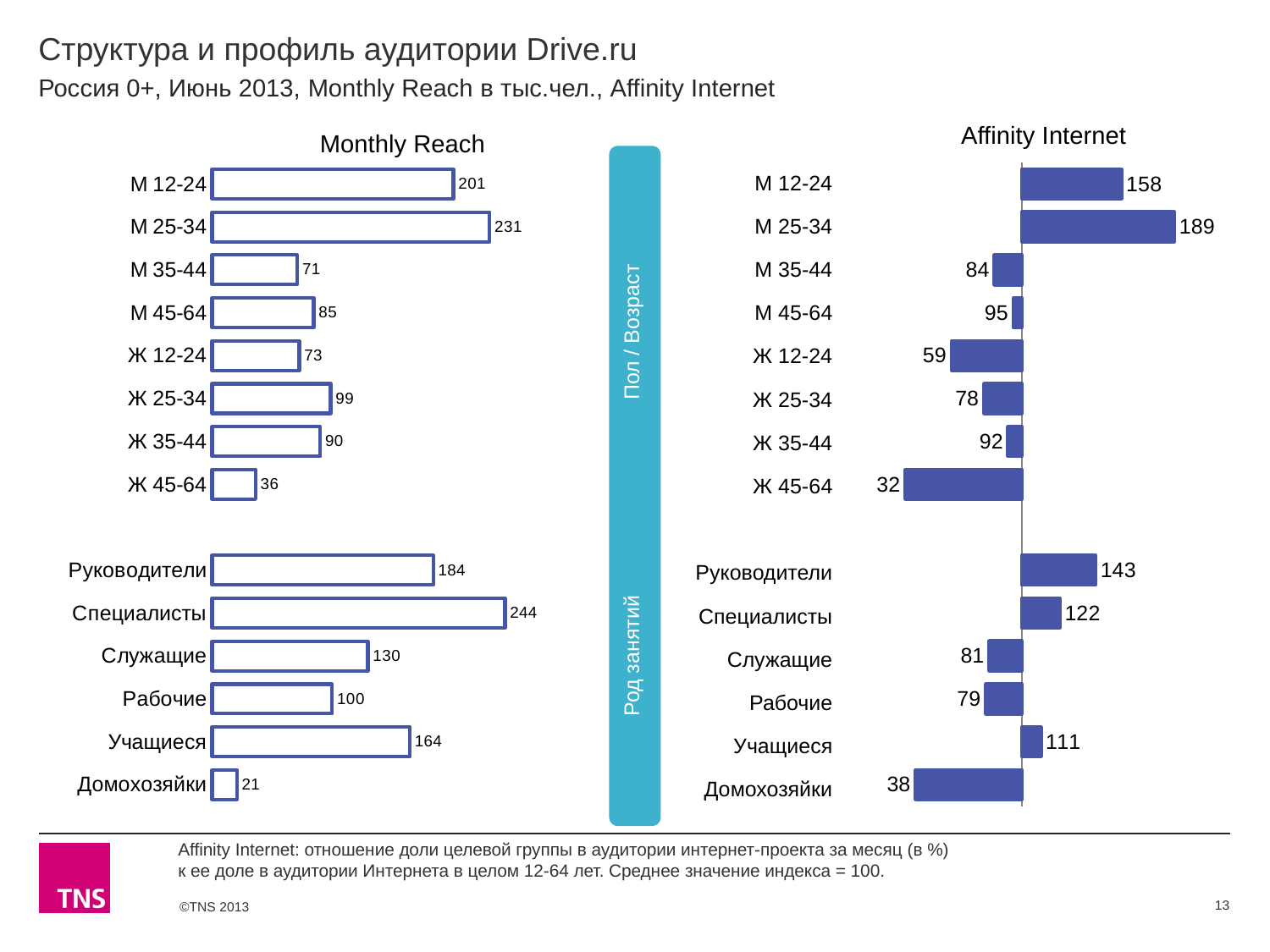
In the Affinity Internet chart, which category has the lowest value? Ж 45-64 In the Monthly Reach chart, what is the value for М 25-34? 231 In the Monthly Reach chart, what is the value for Домохозяйки? 21 In the Affinity Internet chart, which is larger: the value for Учащиеся or the value for Специалисты? Специалисты In the Monthly Reach chart, which category has the highest value? Специалисты In the Affinity Internet chart, what is the difference between the values for Руководители and Рабочие? 64 How many categories are shown in the Monthly Reach chart? 14 What type of chart is the Affinity Internet chart? Bar chart In the Affinity Internet chart, what is the value for Ж 45-64? 32 In the Monthly Reach chart, what is the difference between the values for М 25-34 and М 12-24? 30 In the Affinity Internet chart, what is the value for Руководители? 143 In the Affinity Internet chart, which category has the highest value? М 25-34